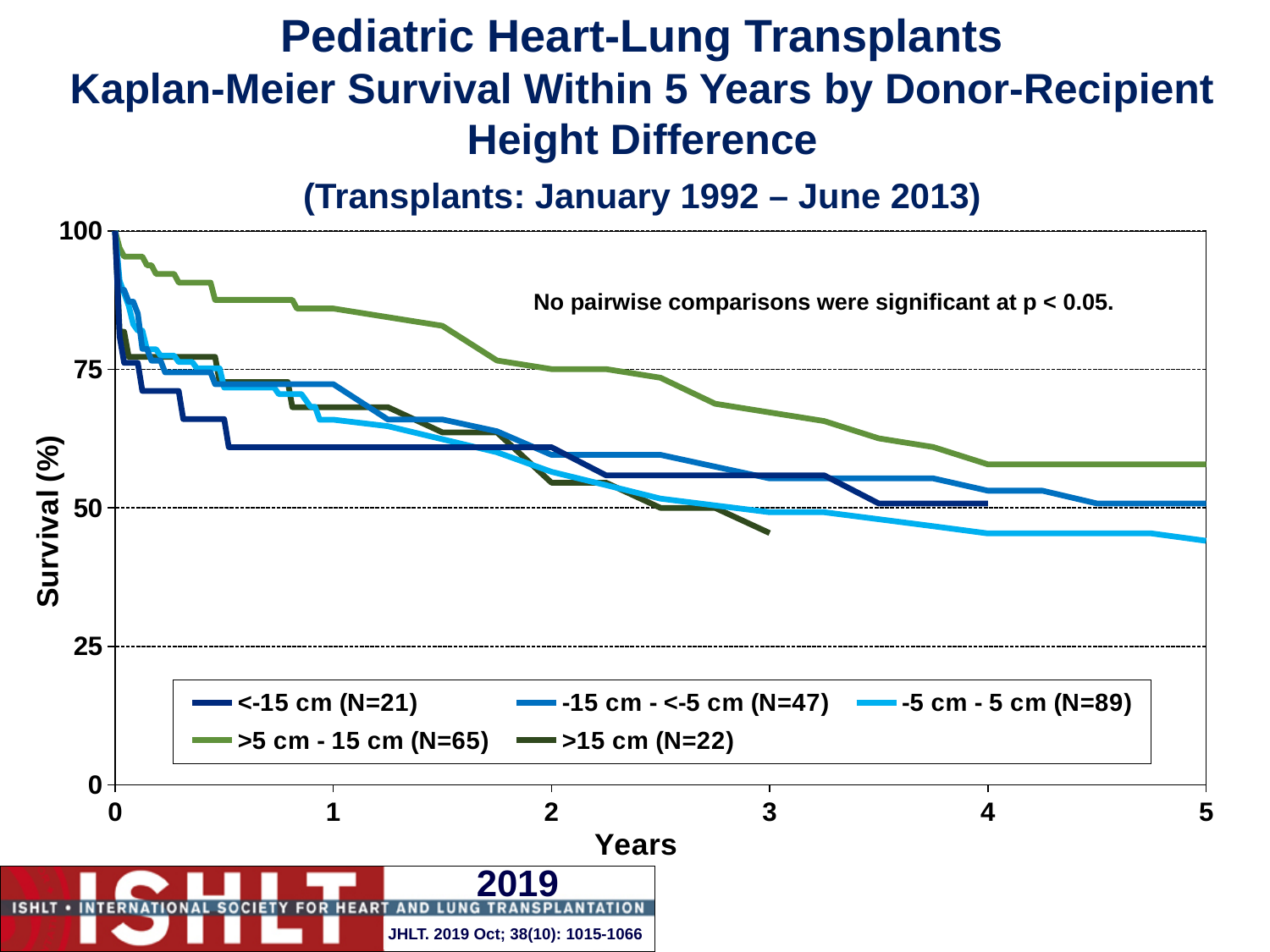
Which series has the lowest survival at 5 years? -5 cm - 5 cm (N=89) At 5 years, which is higher: the survival for the >5 cm - 15 cm group or the -5 cm - 5 cm group? >5 cm - 15 cm group Is the survival for the >5 cm - 15 cm group at 5 years greater or less than 50? greater Is the survival for the >5 cm - 15 cm group at 1 year greater or less than 75? greater How many series does the legend list? 5 Is the survival for the -5 cm - 5 cm group at 5 years greater or less than 50? less Which series has the highest survival at 5 years? >5 cm - 15 cm (N=65) What kind of chart is shown on the slide? Line chart Do the survival curves rise or fall as years increase? fall What is the N for the -5 cm - 5 cm group shown in the legend? 89